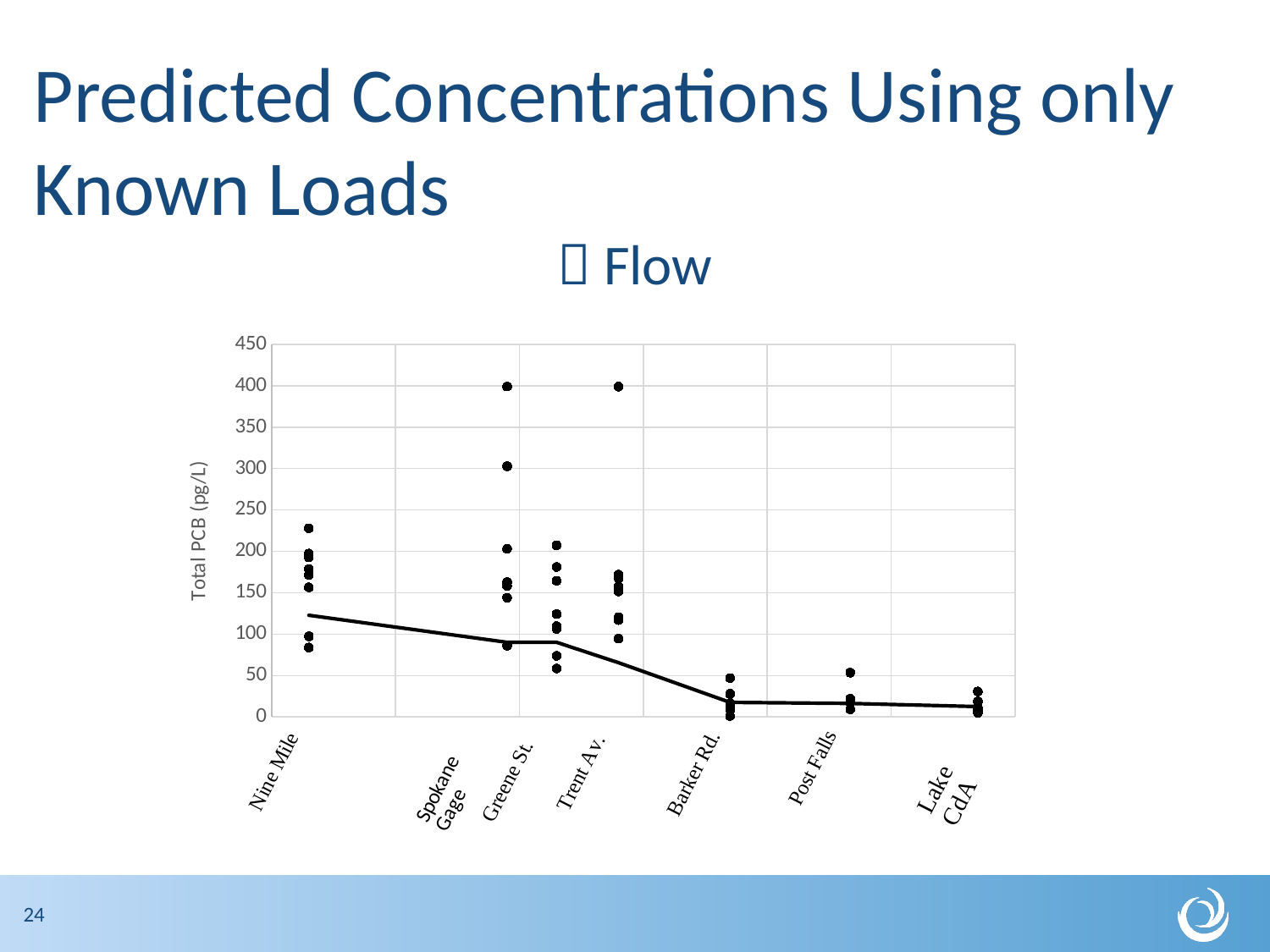
What is the label of the y axis of the chart? Total PCB (pg/L) Is the value of the line at Barker Rd. greater or less than 50? less Is the value of the line at Lake CdA greater or less than 50? less At which x-axis category does the line reach its highest value? Nine Mile Does the line rise or fall moving from Nine Mile to Lake CdA along the x axis? fall How many categories are labelled on the x axis of the chart? 7 Is the highest dot plotted at Greene St. greater or less than 350? greater Which has the larger line value, Nine Mile or Barker Rd.? Nine Mile What is the highest value shown on the y axis of the chart? 450